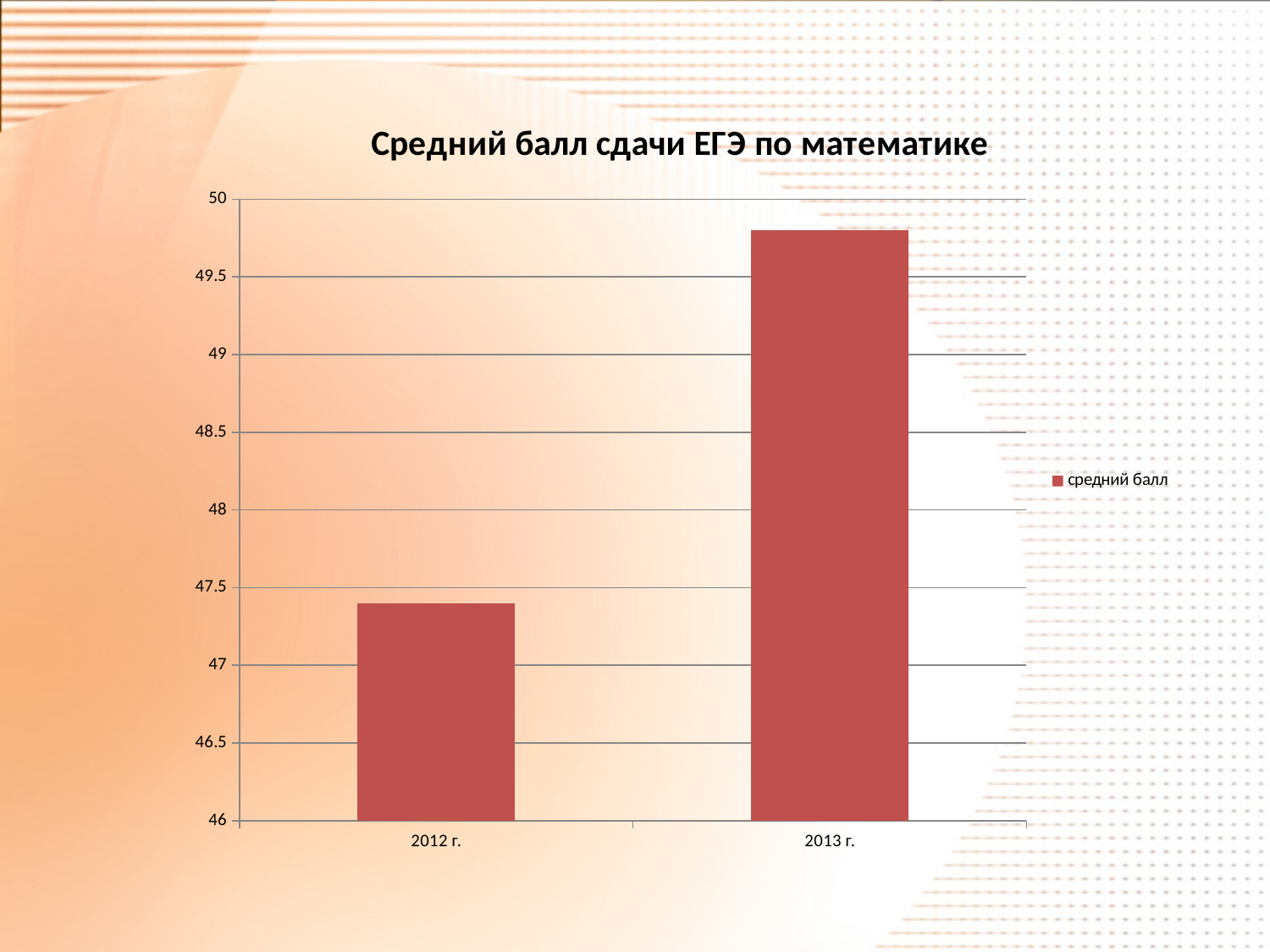
How many categories are shown on the x axis of the chart? 2 Which is larger, the value for 2012 г. or the value for 2013 г.? 2013 г. What is the title of the chart? Средний балл сдачи ЕГЭ по математике Which year has the highest average score? 2013 г. Is the value for 2012 г. greater or less than 48? less Do the values rise or fall from 2012 г. to 2013 г.? rise Which year has the lowest average score? 2012 г. Is the value for 2013 г. greater or less than 49? greater How many series does the legend list? 1 What kind of chart is shown on the slide? bar chart What is the name of the series shown in the legend? средний балл Is the value for 2013 г. greater or less than 49.5? greater